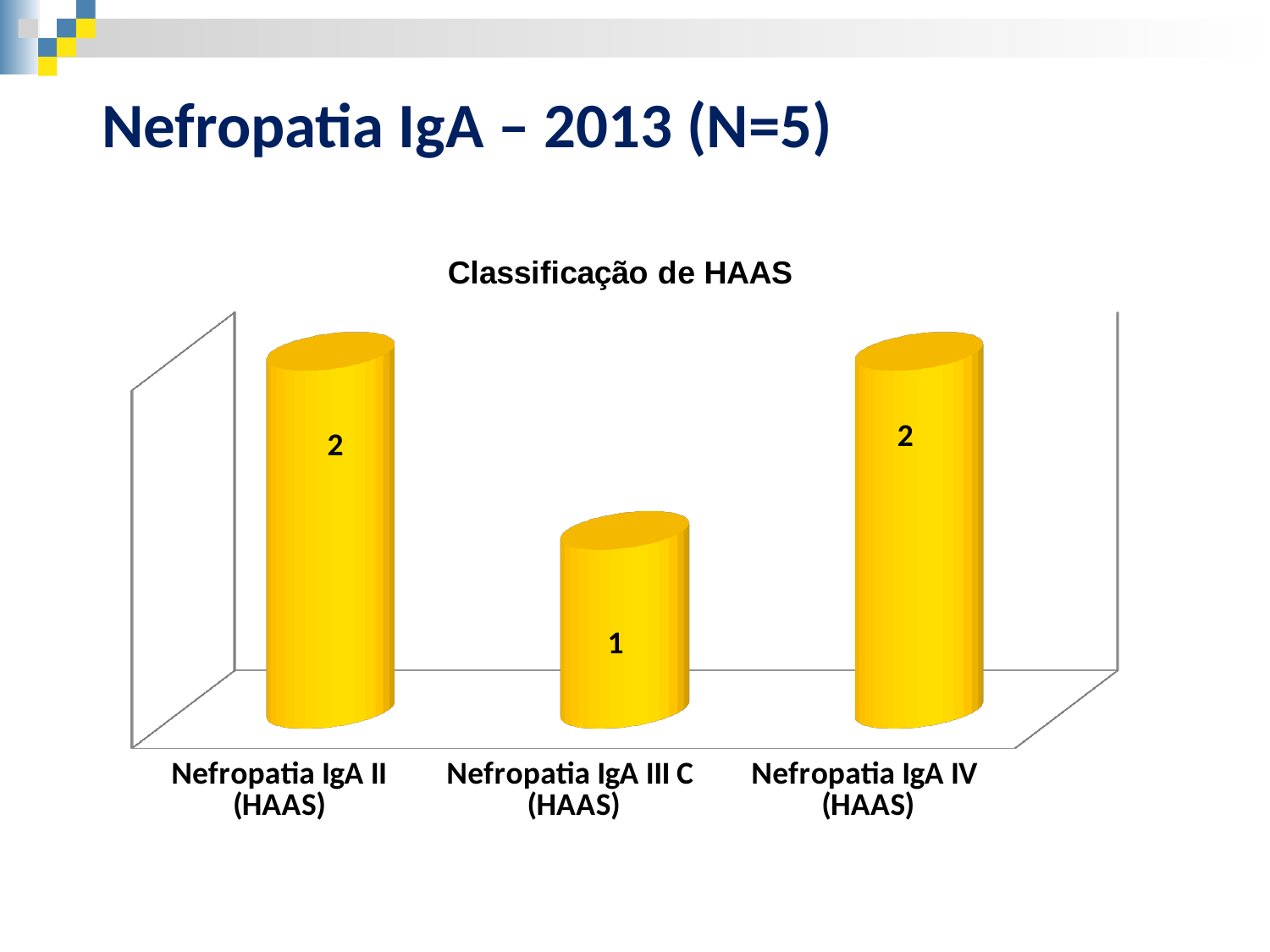
What is the value for Nefropatia IgA IV (HAAS)? 2 Which is larger, the value for Nefropatia IgA IV (HAAS) or Nefropatia IgA III C (HAAS)? Nefropatia IgA IV (HAAS) What is the value for Nefropatia IgA II (HAAS)? 2 What is the total of the values for all three categories? 5 Which category has the lowest value? Nefropatia IgA III C (HAAS) What kind of chart is shown on the slide? Bar chart What colour are the bars in the chart? Yellow What is the value for Nefropatia IgA III C (HAAS)? 1 How many categories are shown in the chart? 3 What is the difference between the values for Nefropatia IgA II (HAAS) and Nefropatia IgA III C (HAAS)? 1 Do the values for Nefropatia IgA II (HAAS) and Nefropatia IgA IV (HAAS) differ? No, both are 2 What is the title of the chart? Classificação de HAAS